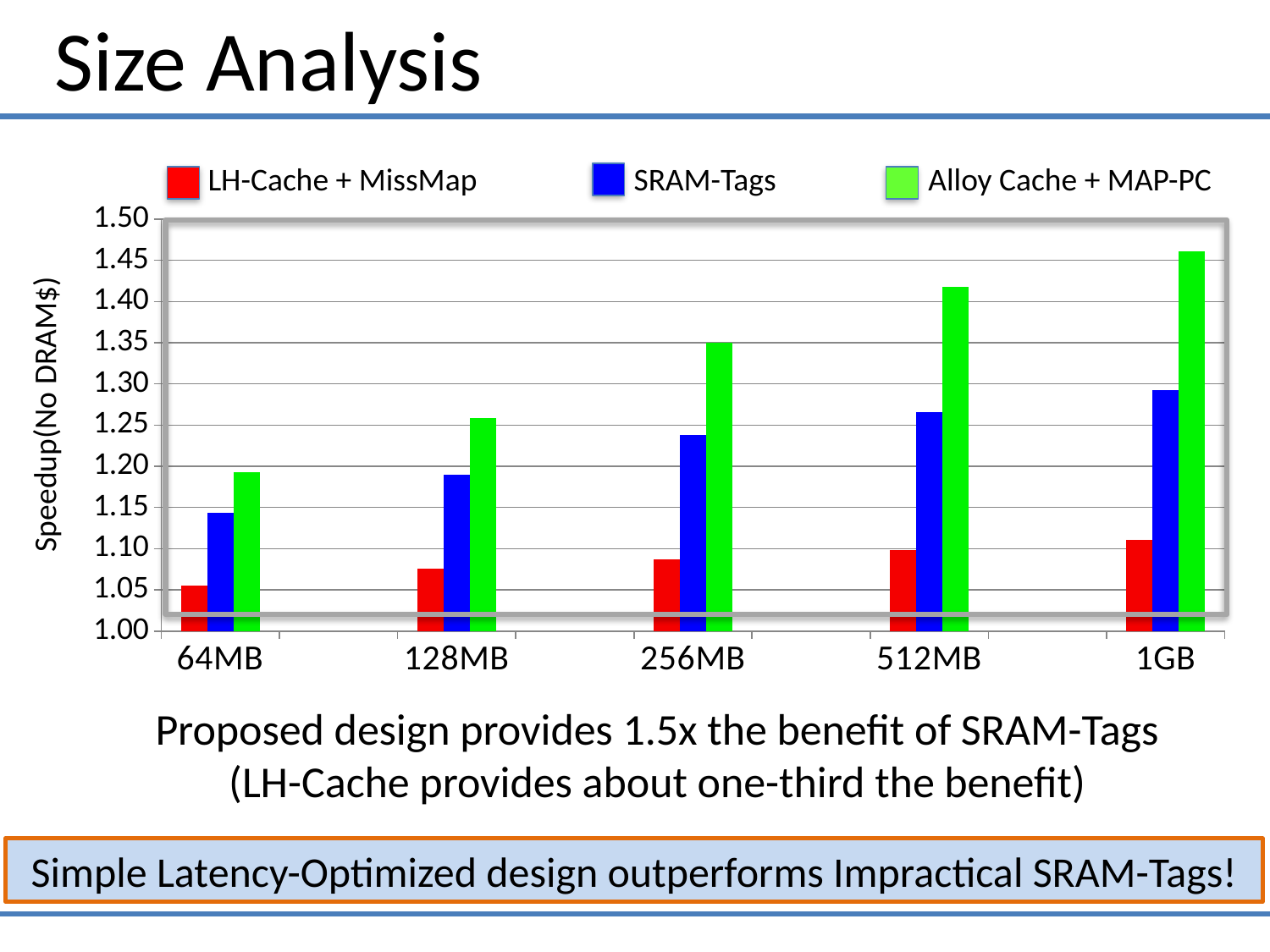
How many series does the legend list? 3 Is the value for LH-Cache + MissMap at 64MB greater or less than 1.10? less What kind of chart is shown on the slide? bar chart Is the value for Alloy Cache + MAP-PC at 256MB greater or less than 1.30? greater Is the value for SRAM-Tags at 512MB greater or less than 1.30? less At 512MB, which is larger: SRAM-Tags or Alloy Cache + MAP-PC? Alloy Cache + MAP-PC At which cache size is the Alloy Cache + MAP-PC speedup highest? 1GB Do the Alloy Cache + MAP-PC values rise or fall as cache size increases from 64MB to 1GB? rise At which cache size is the LH-Cache + MissMap speedup lowest? 64MB How many cache sizes are shown on the x axis? 5